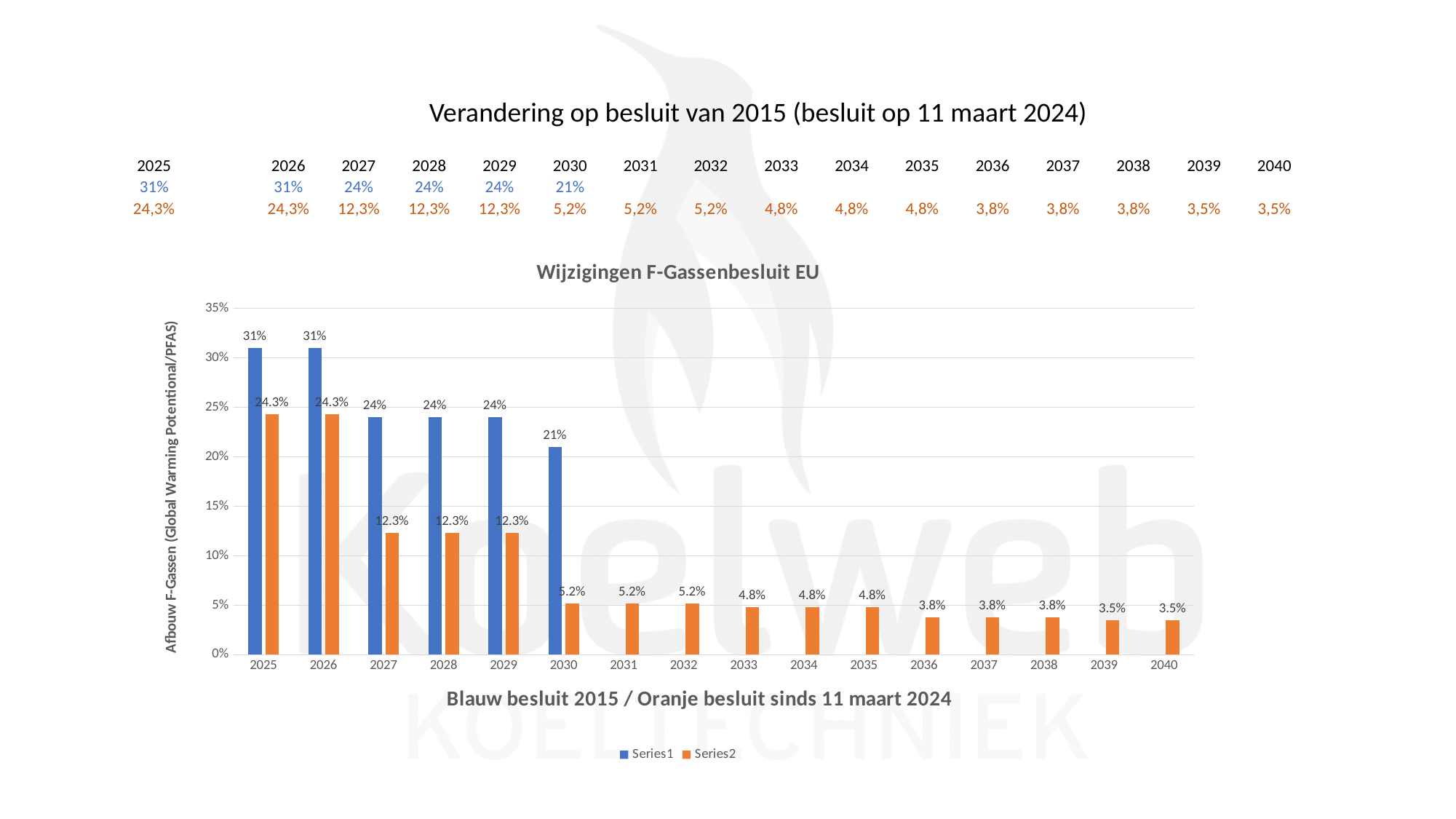
Which year has the lowest Series2 (orange) value? 2039 and 2040 (3.5%) What is the value of Series1 (blue) for 2030? 21% Which is larger for 2025: the Series1 (blue) value or the Series2 (orange) value? Series1 (blue) What is the value of Series2 (orange) for 2033? 4.8% Do the Series2 (orange) values rise or fall from 2025 to 2040? Fall What is the value of Series2 (orange) for 2040? 3.5% Is the Series1 (blue) value for 2029 greater or less than 20%? greater What type of chart is shown on the slide? Bar chart How many years are shown on the x axis of the chart? 16 What is the title of the chart? Wijzigingen F-Gassenbesluit EU What is the difference between the Series1 and Series2 values for 2027? 11.7 percentage points How many series does the chart legend list? 2